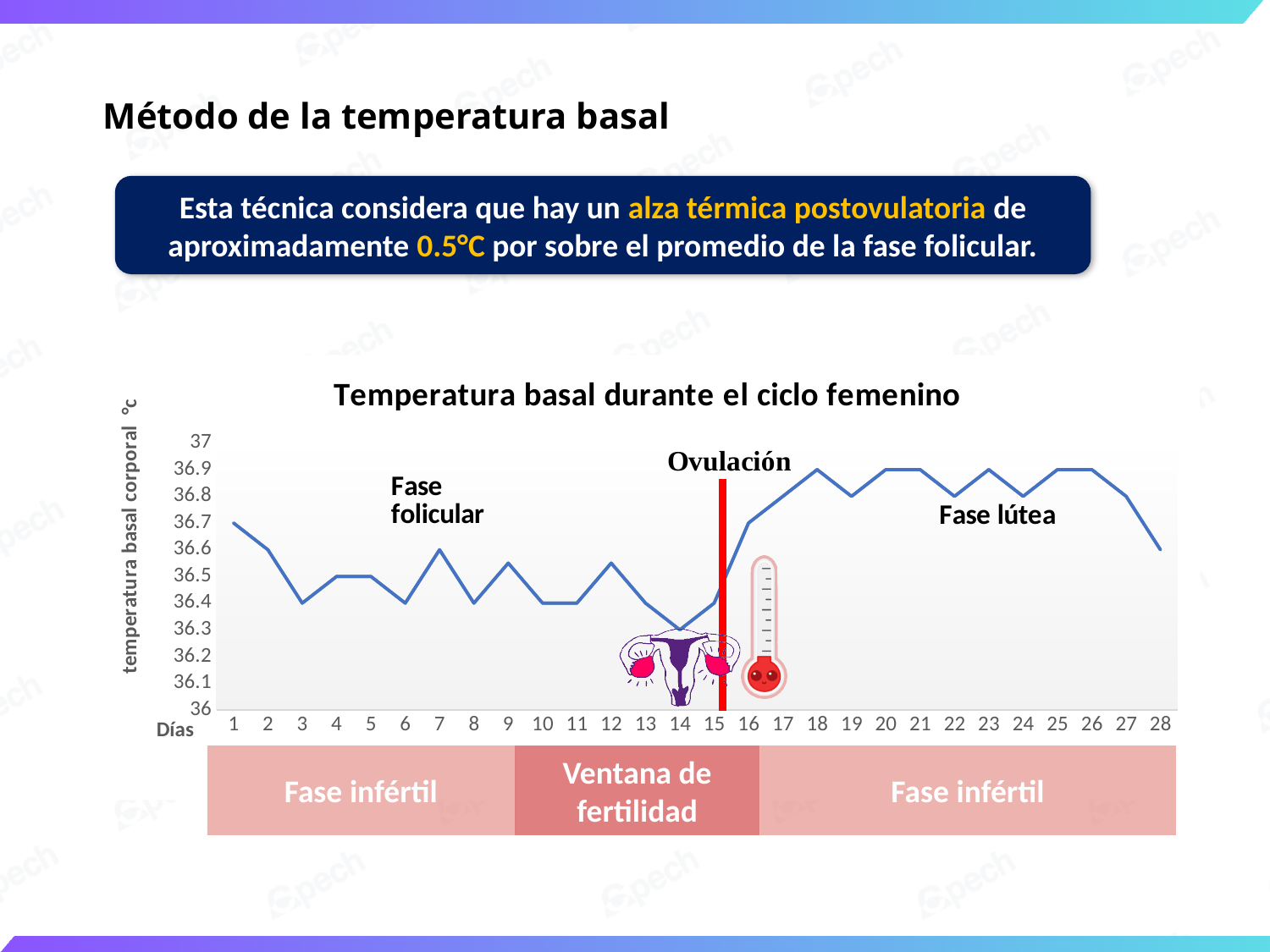
Which day has a higher basal temperature, day 14 or day 20? day 20 What is the title of the chart? Temperatura basal durante el ciclo femenino Is the basal temperature on day 18 greater or less than 36.8? greater Is the basal temperature on day 28 greater or less than 36.5? greater At which day is the red vertical line labelled 'Ovulación' placed on the chart? 15 What is the basal temperature on day 1? 36.7 On which day does the basal temperature reach its lowest value? 14 What is the basal temperature on day 14? 36.3 What kind of chart is shown on the slide? line chart How many days (data points) are plotted on the x axis of the chart? 28 Does the basal temperature rise or fall from day 14 to day 18? rise Is the basal temperature on day 10 greater or less than 36.5? less